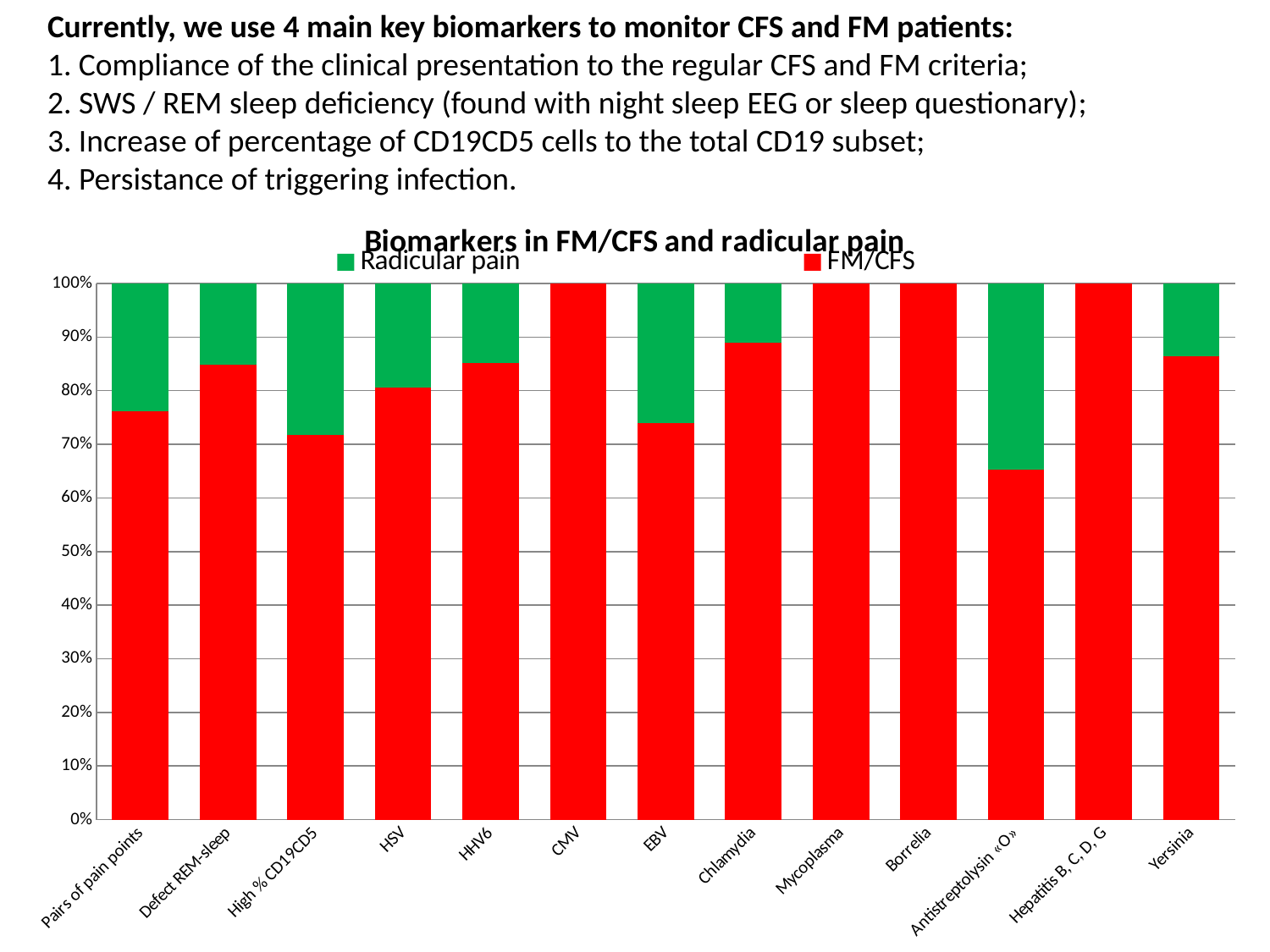
What kind of chart is shown on the slide? stacked bar chart What is the title of the chart? Biomarkers in FM/CFS and radicular pain Is the FM/CFS value for Antistreptolysin «O» greater or less than 70%? less What is the Radicular pain value for Borrelia? 0% Is the FM/CFS value for Defect REM-sleep greater or less than 80%? greater Which has the larger FM/CFS share, Pairs of pain points or Antistreptolysin «O»? Pairs of pain points Which category has the lowest FM/CFS share? Antistreptolysin «O» Which category has the largest Radicular pain share? Antistreptolysin «O» How many series does the legend list? 2 What is the FM/CFS value for CMV? 100% Is the FM/CFS value for EBV greater or less than 80%? less How many categories are shown on the x axis? 13